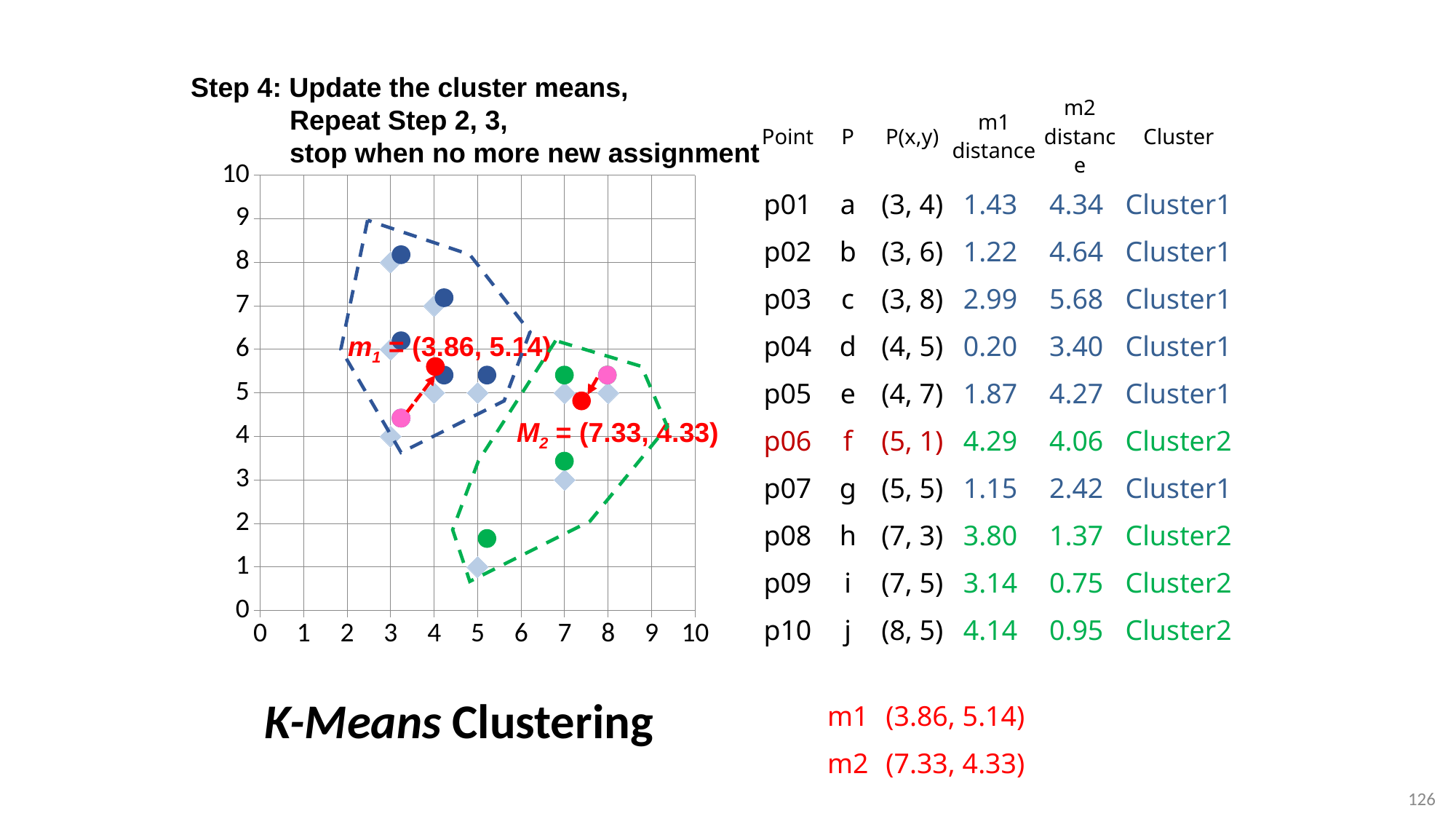
Which point has the lowest y-coordinate on the chart? f (5, 1) What kind of chart is shown on the slide? scatter chart How many data points (light-blue diamond markers) are plotted on the chart? 10 Which point has the highest y-coordinate on the chart? c (3, 8) Which cluster mean has the larger x-coordinate, m1 or M2? M2 Is the y-coordinate of the cluster mean M2 greater or less than 5? less How many clusters are outlined with dashed lines on the chart? 2 What are the coordinates of the cluster mean M2 shown on the chart? (7.33, 4.33) What are the coordinates of the cluster mean m1 shown on the chart? (3.86, 5.14) What is the difference between the x-coordinates of M2 and m1? 3.47 What is the maximum value shown on the y axis of the chart? 10 Is the x-coordinate of the cluster mean m1 greater or less than 4? less